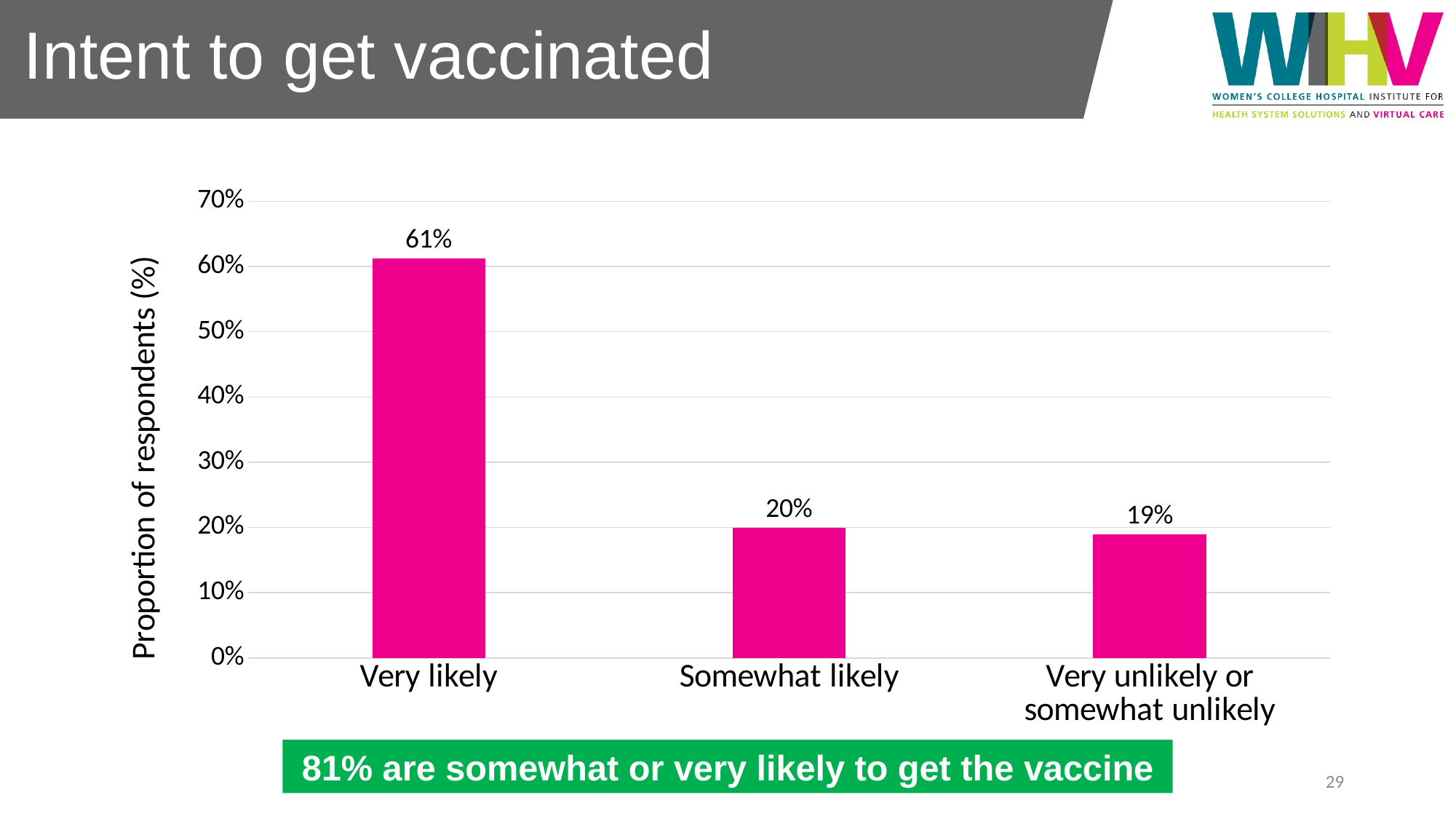
What is the difference in percentage points between 'Very likely' and 'Very unlikely or somewhat unlikely'? 42 Which is larger: the value for 'Very likely' or the value for 'Somewhat likely'? Very likely What is the difference in percentage points between 'Very likely' and 'Somewhat likely'? 41 How many categories are shown on the x axis of the chart? 3 Which category has the highest proportion of respondents? Very likely What percentage of respondents are 'Somewhat likely' to get vaccinated? 20% What is the label of the y axis of the chart? Proportion of respondents (%) What type of chart is shown on the slide? Bar chart Is the value for 'Very unlikely or somewhat unlikely' greater or less than 30%? less What percentage of respondents are 'Very likely' to get vaccinated? 61% What percentage of respondents are 'Very unlikely or somewhat unlikely' to get vaccinated? 19% Is the value for 'Very likely' greater or less than 50%? greater